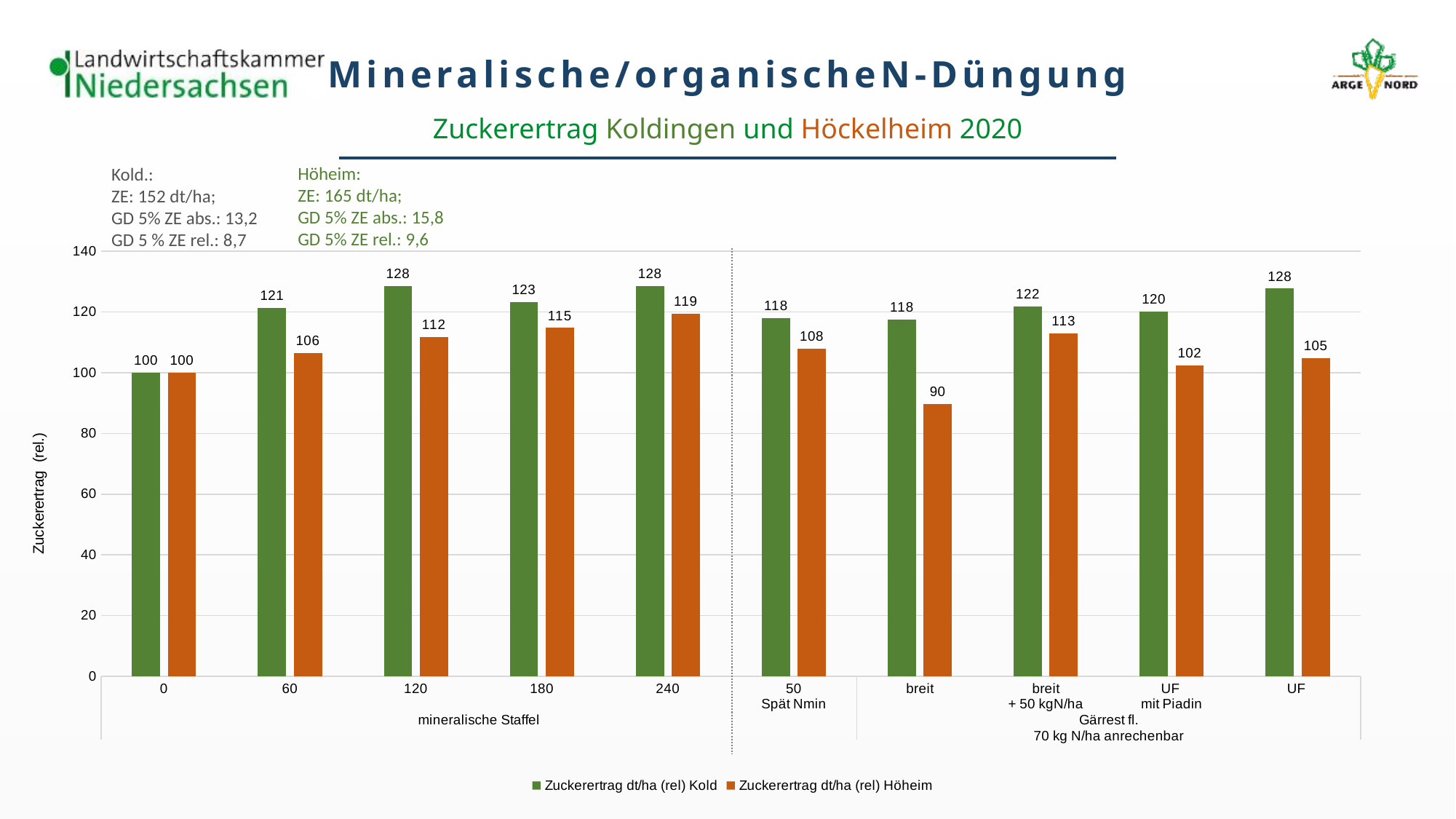
Which category has the lowest Zuckerertrag (rel) value for Höheim? breit What is the Zuckerertrag (rel) value for Höheim at 60 in the mineralische Staffel? 106 Which category has the highest Zuckerertrag (rel) value for Höheim? 240 What is the Zuckerertrag (rel) value for Kold at 180 in the mineralische Staffel? 123 Which is larger in the 'UF mit Piadin' category, the Kold value or the Höheim value? Kold How many categories are shown on the x axis? 10 How many series does the legend list? 2 What is the Zuckerertrag (rel) value for Höheim in the 'breit' category? 90 Do the Höheim values rise or fall from 0 to 240 in the mineralische Staffel? rise What type of chart is shown on the slide? bar chart What is the difference between the Kold and Höheim values in the 'breit' category? 28 What colour are the bars for the Höheim series? orange